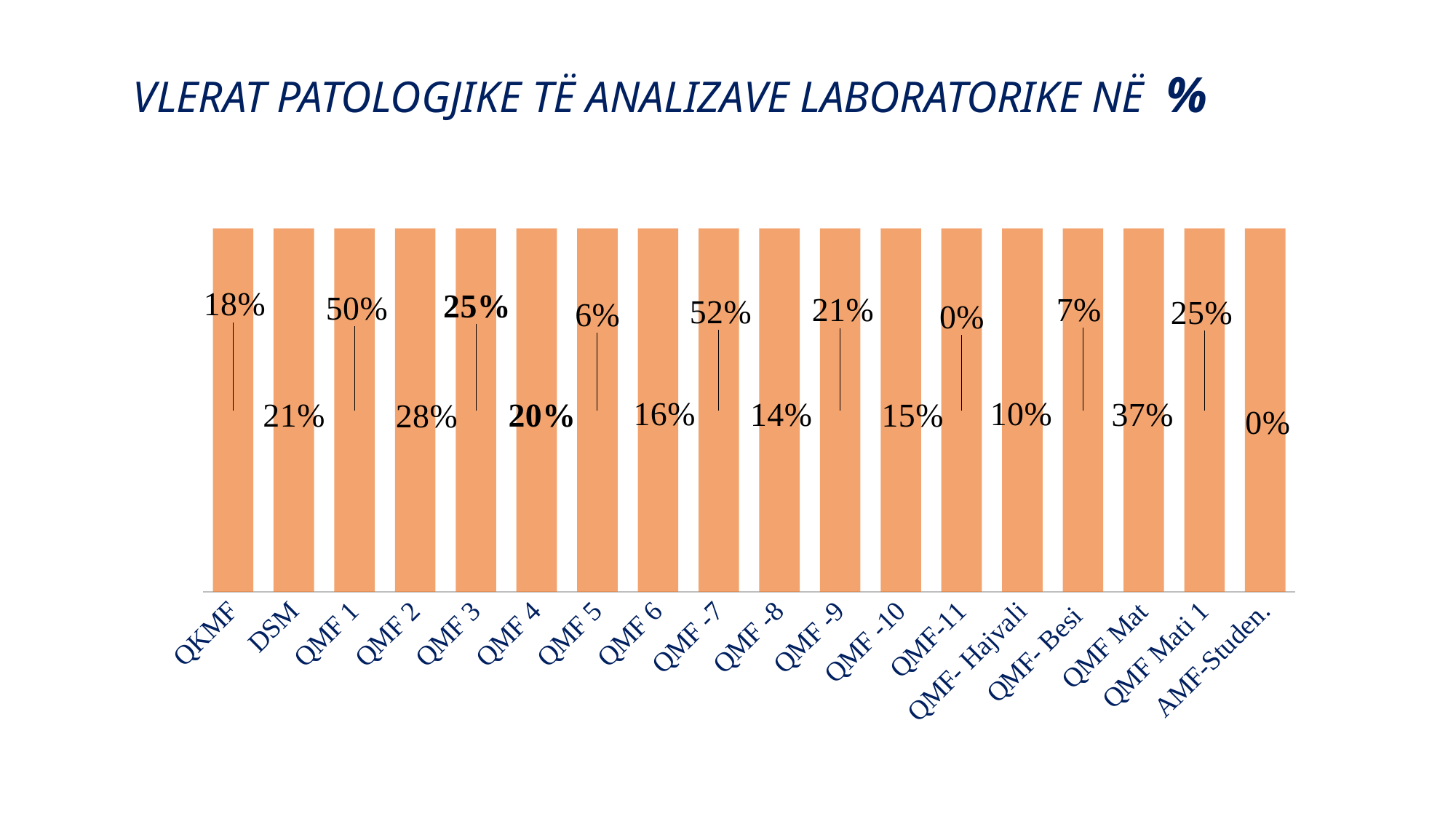
Which category has the highest value? QMF -7 What is the value shown for QKMF? 18% What is the difference between the values for QMF -7 and QMF 1? 2% What kind of chart is shown on the slide? Bar chart What is the value shown for QMF- Hajvali? 10% How many categories are shown on the x axis? 18 What is the value shown for QMF 5? 6% What is the value shown for QMF Mat? 37% Which has a larger value, QMF 3 or QMF 4? QMF 3 What is the difference between the values for QMF Mat and QMF 2? 9% Which has a larger value, QMF- Besi or QMF -10? QMF -10 What is the value shown for QMF 1? 50%